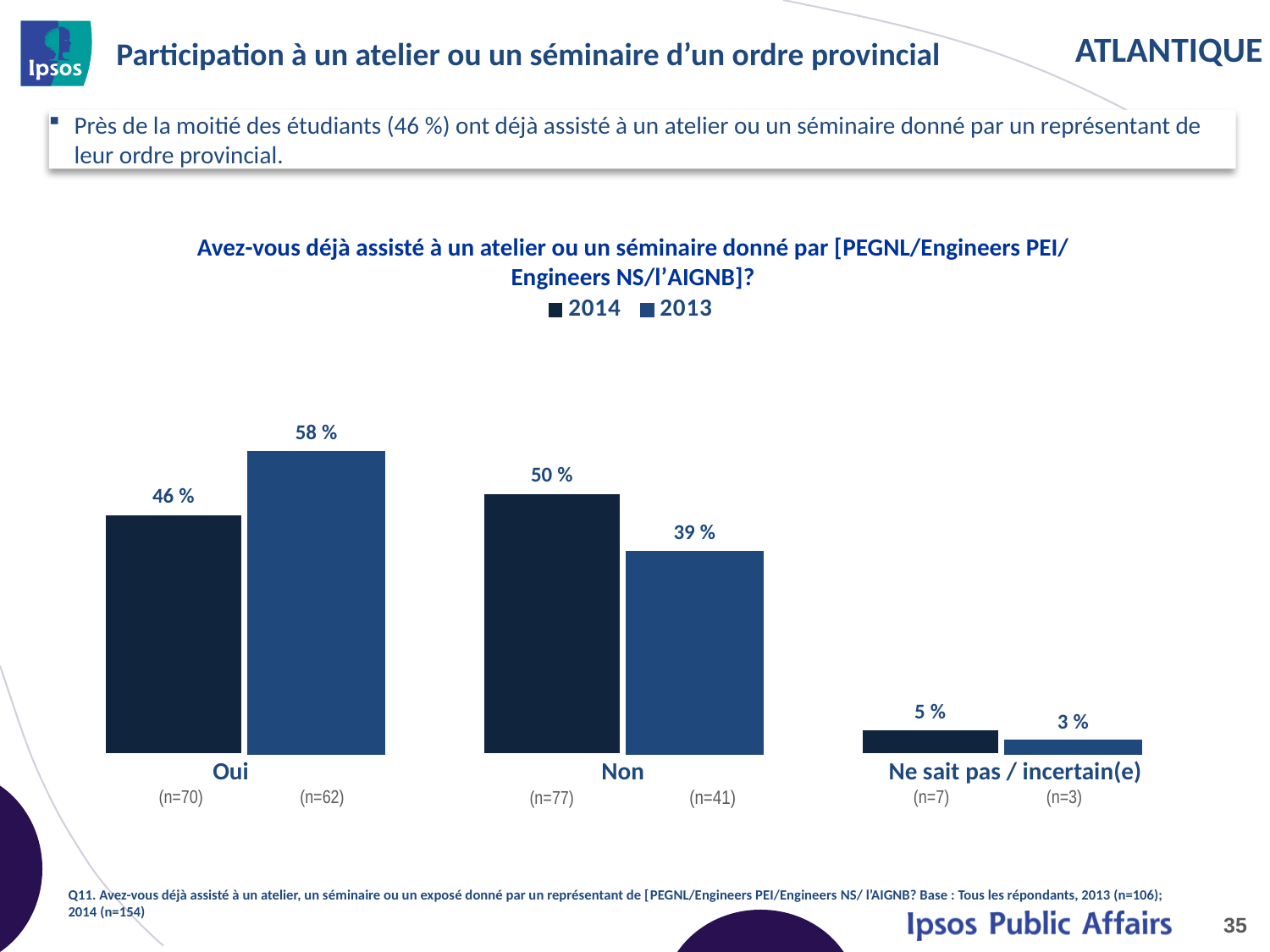
Which is larger for "Non": the 2014 value or the 2013 value? 2014 How many series does the legend list? 2 What kind of chart is shown on the slide? Bar chart Which category has the lowest value in the 2014 series? Ne sait pas / incertain(e) How many categories are shown on the x axis? 3 What is the difference between the 2013 and 2014 values for "Oui"? 12 % What is the value for "Non" in the 2013 series? 39 % Which category has the highest value in the 2013 series? Oui What is the value for "Ne sait pas / incertain(e)" in the 2014 series? 5 % What is the value for "Oui" in the 2014 series? 46 % Which series is shown in the darker navy colour? 2014 What is the difference between the 2014 and 2013 values for "Non"? 11 %